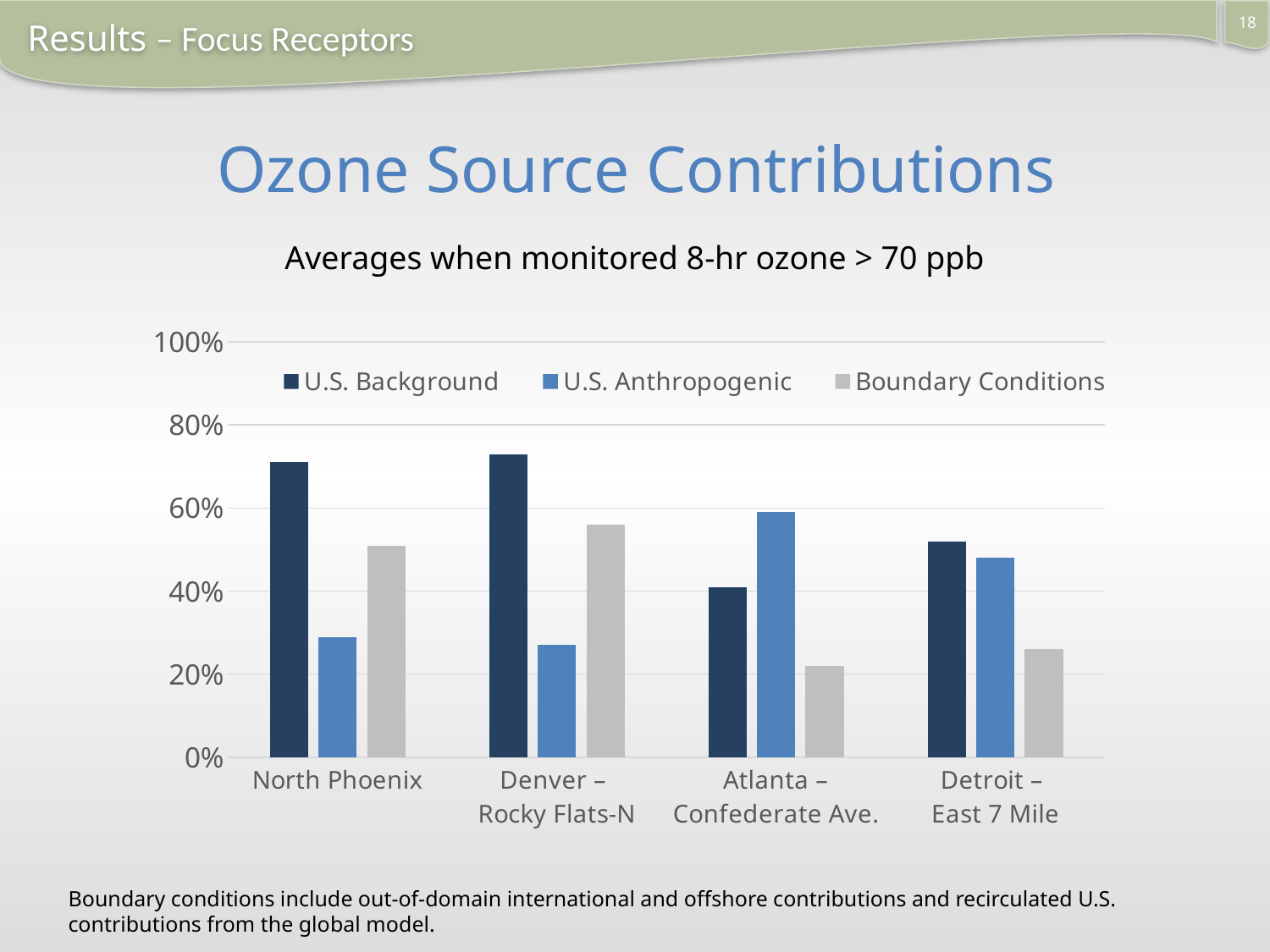
Is the Boundary Conditions value for Denver – Rocky Flats-N greater or less than 40%? greater Which site has the lowest U.S. Background contribution? Atlanta – Confederate Ave. Is the U.S. Anthropogenic value for North Phoenix greater or less than 40%? less At Atlanta – Confederate Ave., which is larger: U.S. Background or U.S. Anthropogenic? U.S. Anthropogenic What kind of chart is shown on the slide? Bar chart How many receptor sites (categories) are shown on the x axis? 4 At North Phoenix, which is larger: U.S. Background or Boundary Conditions? U.S. Background Is the U.S. Background value for North Phoenix greater or less than 60%? greater How many series does the legend list? 3 Which site has the highest U.S. Anthropogenic contribution? Atlanta – Confederate Ave. What is the title of the chart? Ozone Source Contributions